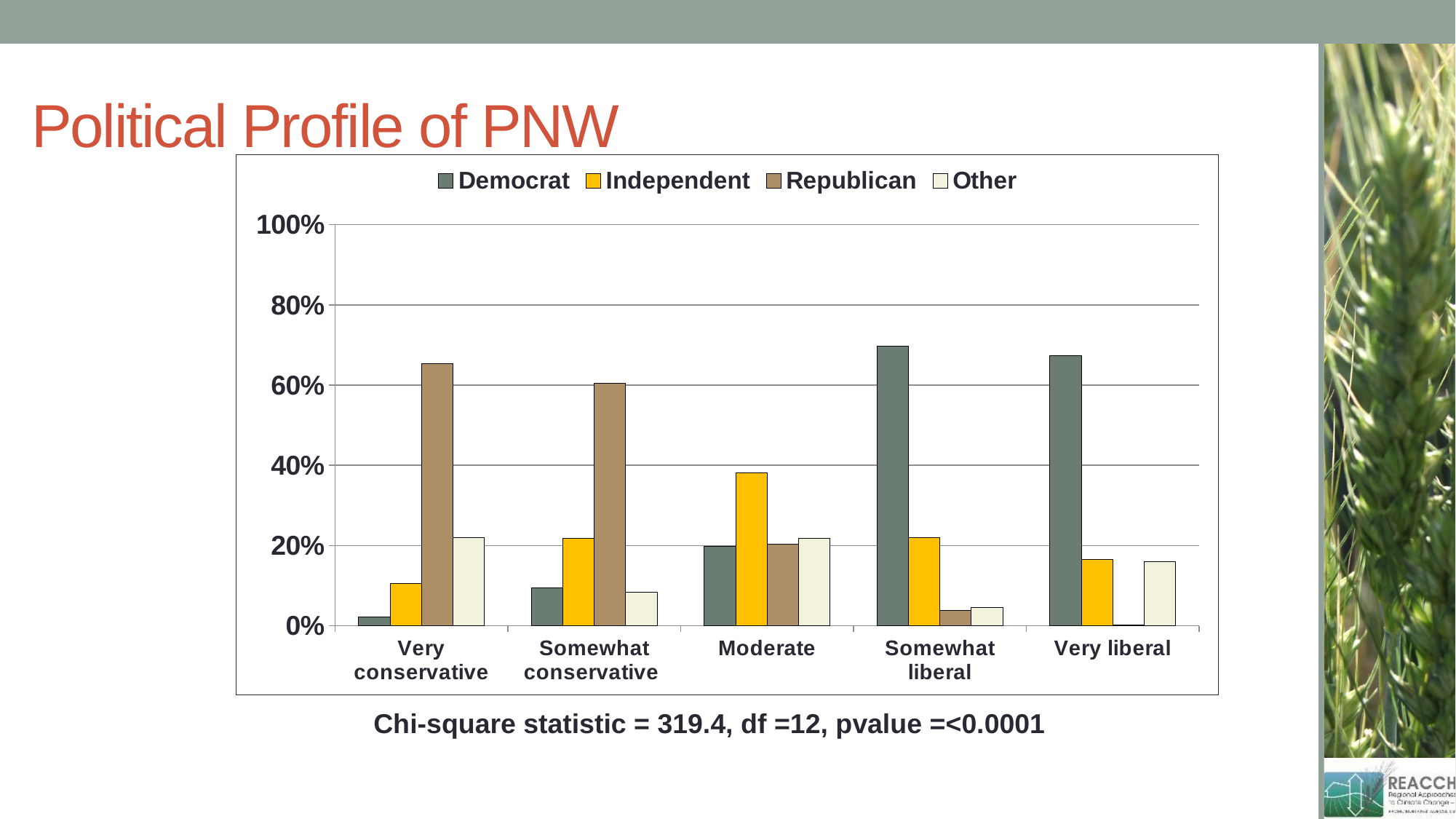
What is the chi-square statistic reported below the chart? 319.4 Is the Independent value for Moderate greater or less than 40%? less Is the Republican value for Very conservative greater or less than 60%? greater In the Somewhat conservative category, which is larger: the Republican value or the Independent value? Republican Is the Republican value for Somewhat liberal greater or less than 20%? less How many series does the legend list? 4 What kind of chart is shown on the slide? bar chart How many political-orientation categories are shown on the x axis? 5 In which category is the Independent value highest? Moderate In which category is the Republican value lowest? Very liberal Which series has the highest value in the Very conservative category? Republican